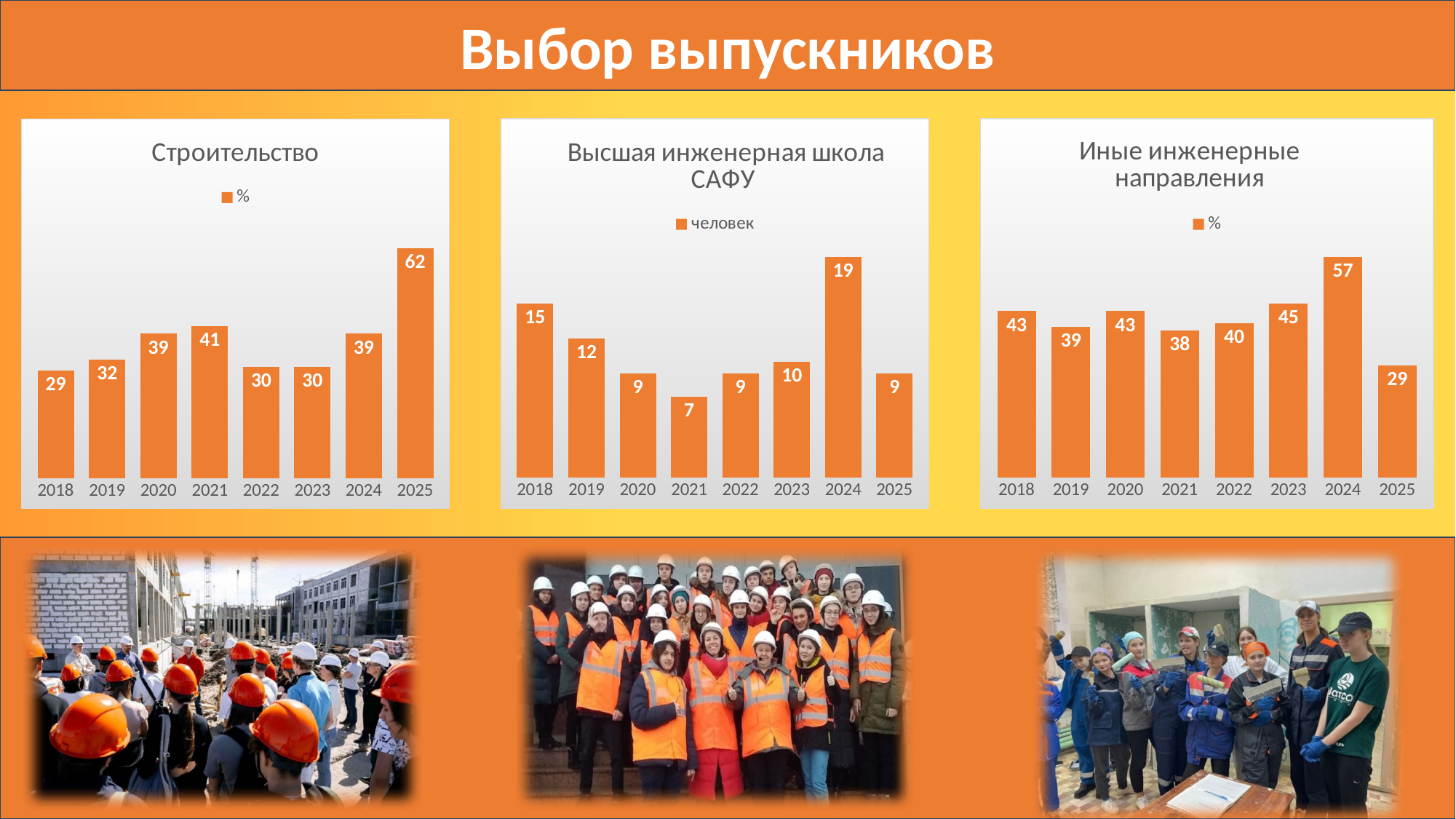
In the "Иные инженерные направления" chart, what is the value for 2023? 45 In the "Высшая инженерная школа САФУ" chart, which year has the highest value? 2024 In the "Высшая инженерная школа САФУ" chart, what is the value for 2021? 7 How many years are shown on the x axis of the "Строительство" chart? 8 What kind of chart is the "Высшая инженерная школа САФУ" chart? bar chart What is the legend entry of the "Высшая инженерная школа САФУ" chart? человек In the "Иные инженерные направления" chart, what is the difference between the values for 2024 and 2025? 28 In the "Строительство" chart, which year has the lowest value? 2018 In the "Высшая инженерная школа САФУ" chart, which is larger, the value for 2018 or the value for 2019? 2018 In the "Строительство" chart, what is the difference between the values for 2025 and 2024? 23 In the "Иные инженерные направления" chart, which year has the lowest value? 2025 In the "Строительство" chart, what is the value for 2025? 62